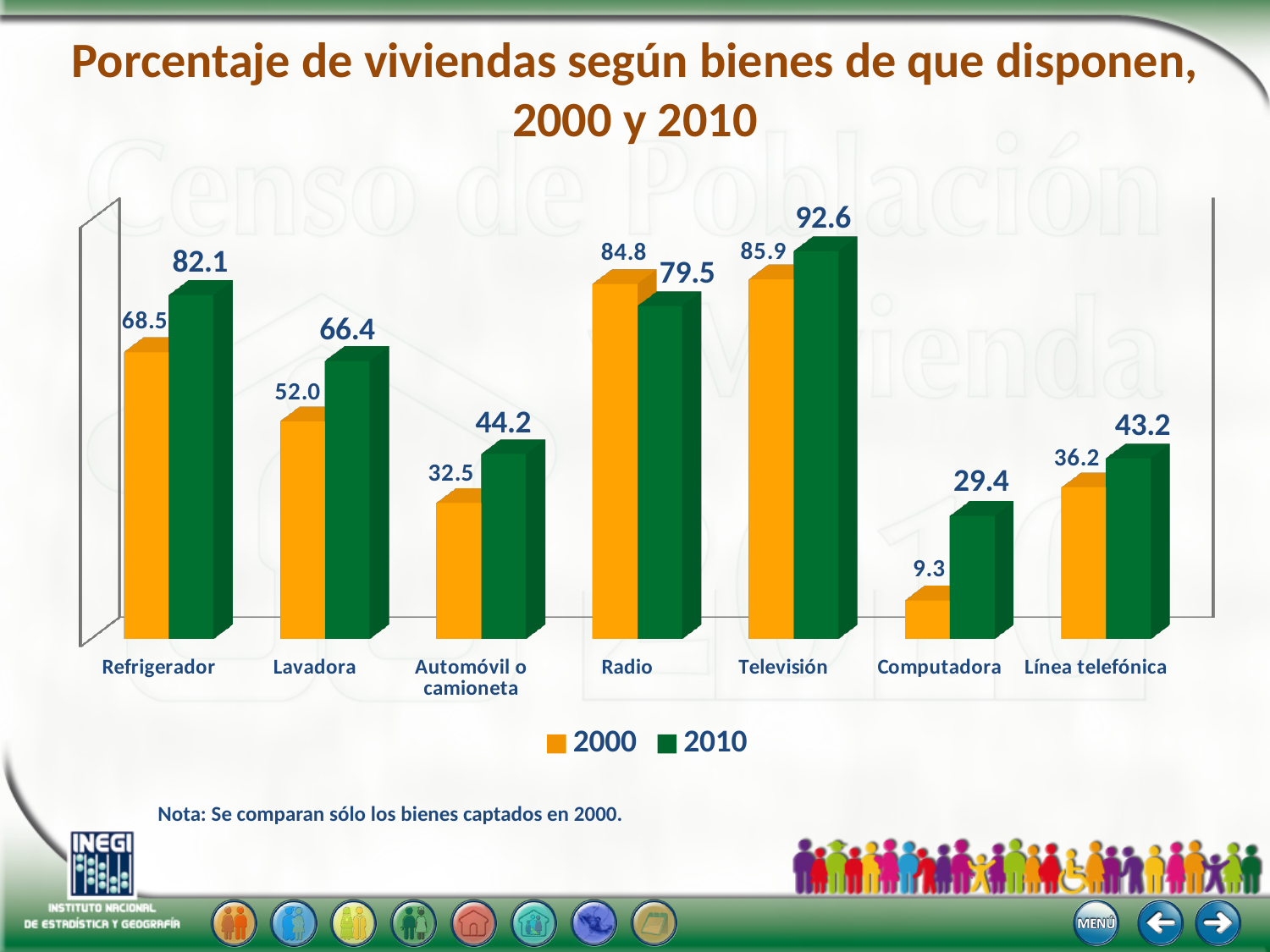
Which category has the highest value in 2010? Televisión How many categories are shown on the x axis? 7 What is the value for Refrigerador in 2010? 82.1 Which is larger for Radio: the 2000 value or the 2010 value? 2000 What kind of chart is shown on the slide? Bar chart What is the difference between the 2000 and 2010 values for Radio? 5.3 How many series does the legend list? 2 What is the value for Radio in 2000? 84.8 What is the value for Computadora in 2000? 9.3 Which category has the lowest value in 2000? Computadora Which colour represents the 2010 series? Green What is the difference between the 2010 and 2000 values for Computadora? 20.1